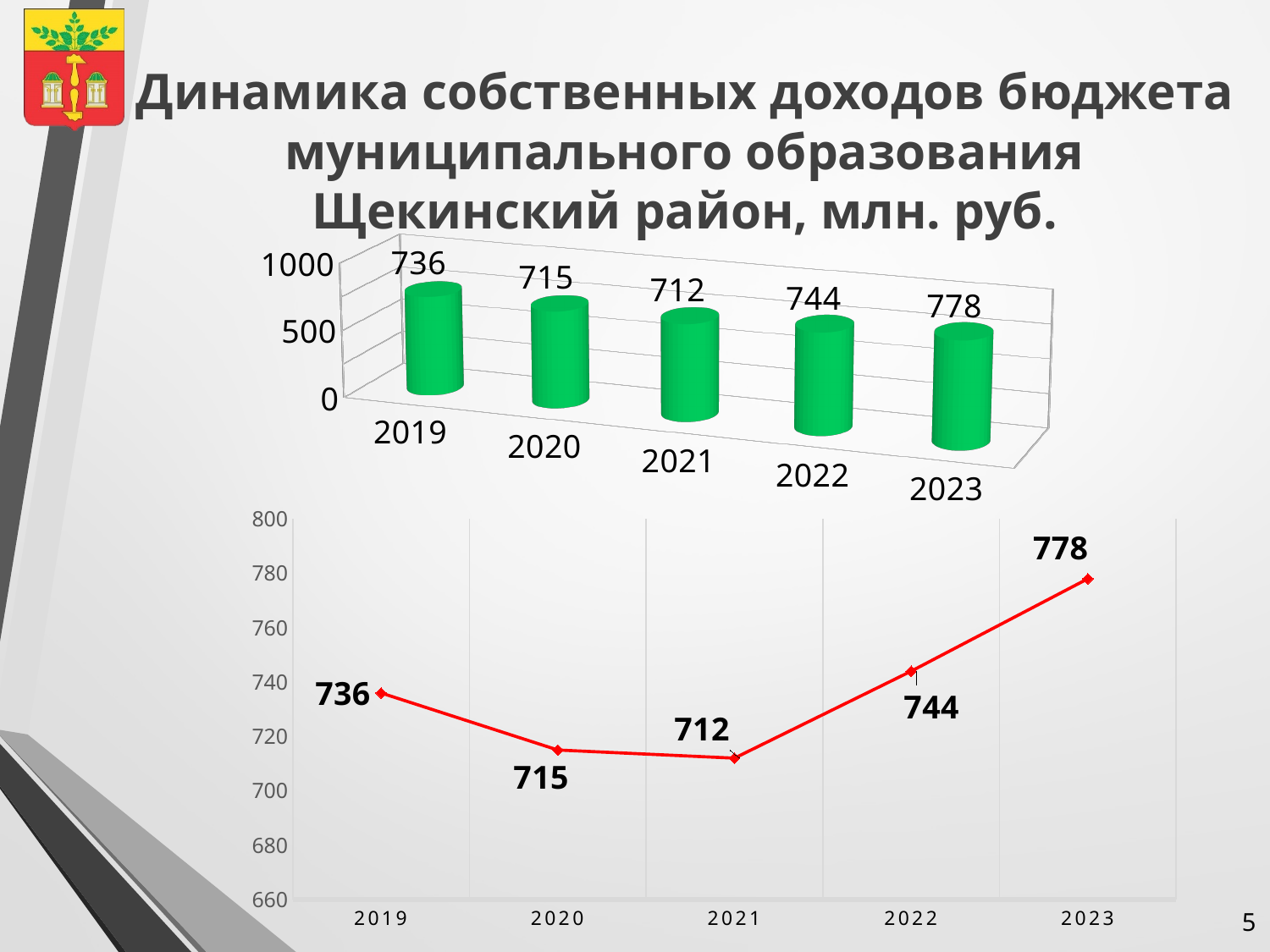
In the bottom line chart, what is the difference between the values for 2022 and 2021? 32 In the top chart, which year has the highest value? 2023 In the bottom line chart, is the value for 2023 greater or less than 760? greater In the top chart, what is the value for 2021? 712 What kind of chart is the bottom chart on the slide? line chart In the top chart, which is larger: the value for 2019 or the value for 2020? 2019 What kind of chart is the top chart on the slide? bar chart In the bottom line chart, which year has the lowest value? 2021 How many years are shown in the top chart? 5 In the bottom line chart, what is the value for 2022? 744 In the bottom line chart, do the values rise or fall from 2021 to 2023? rise In the top chart, what is the difference between the values for 2023 and 2019? 42